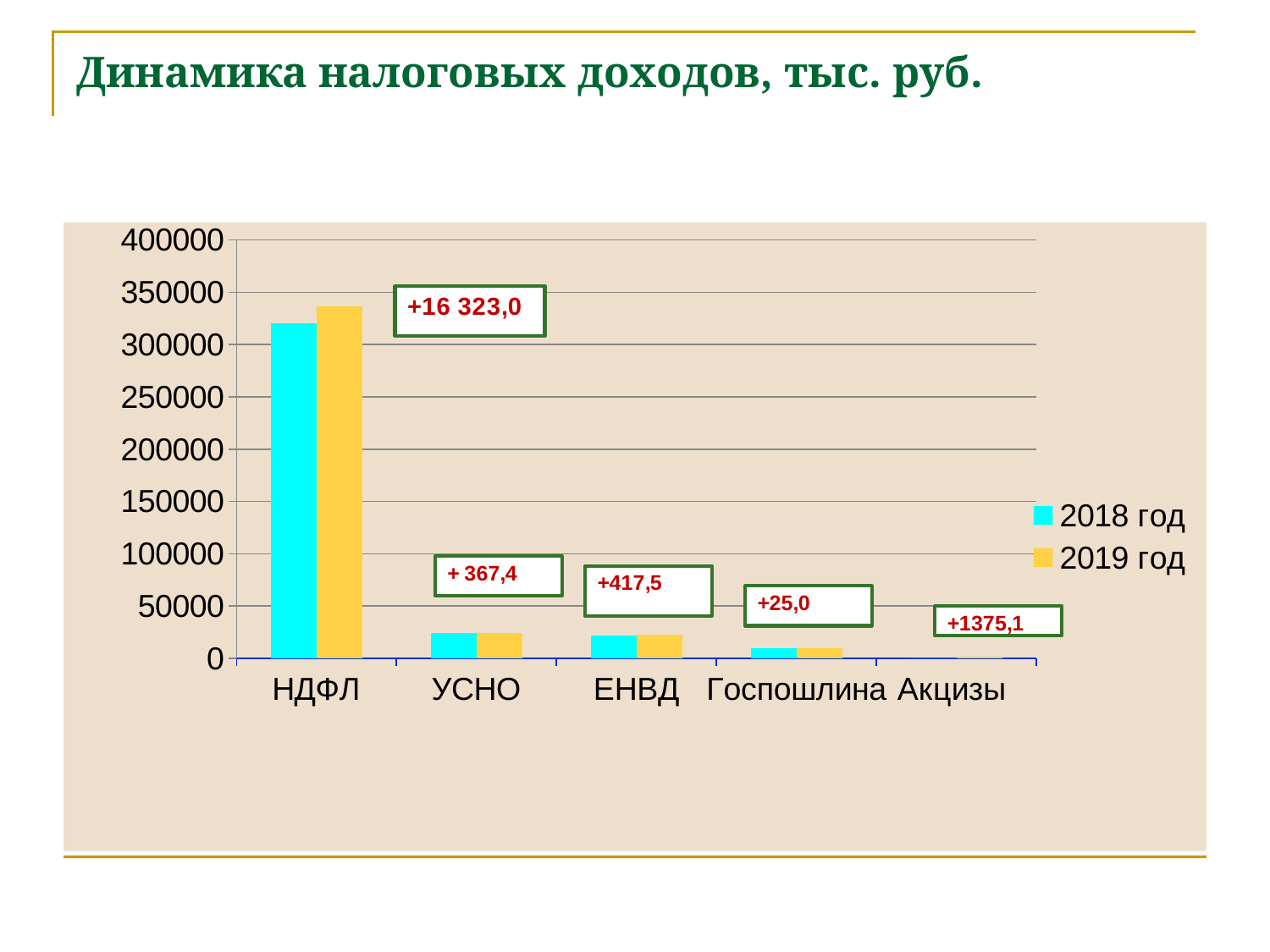
Is the value for УСНО in 2019 год greater or less than 50000? less Is the value for НДФЛ in 2018 год greater or less than 300000? greater Which category has the lowest values in the chart? Акцизы What change is annotated above the Акцизы bars? +1375,1 Which colour represents the 2019 год series in the legend? yellow For НДФЛ, which is larger: the 2018 год value or the 2019 год value? 2019 год How many series does the legend list? 2 What change is annotated above the НДФЛ bars? +16 323,0 What kind of chart is shown on the slide? bar chart Which category has the highest values in the chart? НДФЛ What is the title of the slide's chart? Динамика налоговых доходов, тыс. руб. How many categories are shown on the x axis? 5